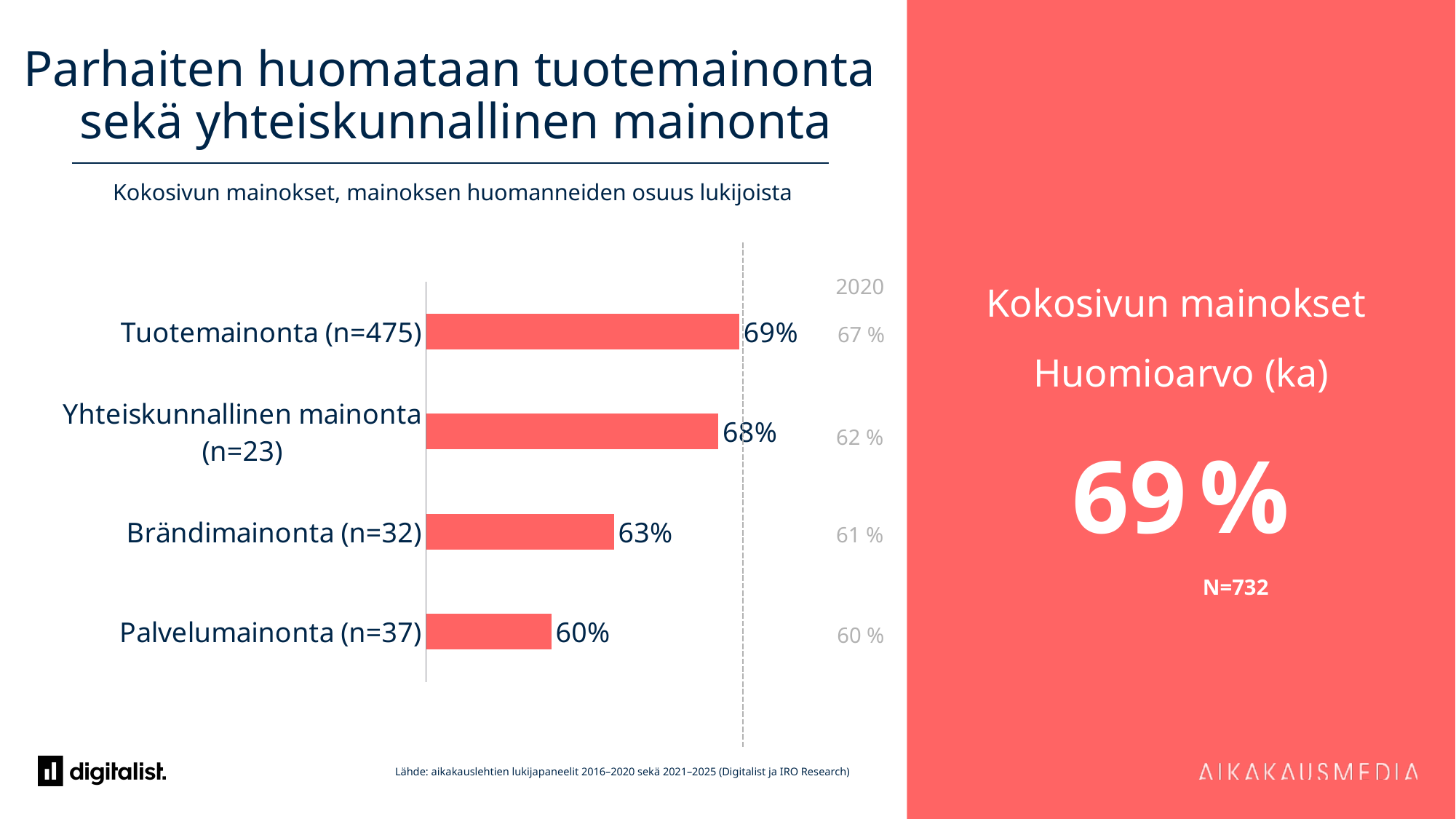
Which category has the highest value? Tuotemainonta (n=475) What kind of chart is shown on the slide? Bar chart Which category has the lowest value? Palvelumainonta (n=37) What 2020 value is shown next to Tuotemainonta (n=475)? 67 % What is the subtitle printed above the chart? Kokosivun mainokset, mainoksen huomanneiden osuus lukijoista What is the value for Brändimainonta (n=32)? 63% What is the value for Tuotemainonta (n=475)? 69% Which is larger, the value for Brändimainonta (n=32) or Palvelumainonta (n=37)? Brändimainonta (n=32) What is the value for Yhteiskunnallinen mainonta (n=23)? 68% How many categories are shown in the bar chart? 4 What is the value for Palvelumainonta (n=37)? 60% What is the difference between the values for Tuotemainonta (n=475) and Palvelumainonta (n=37)? 9 percentage points